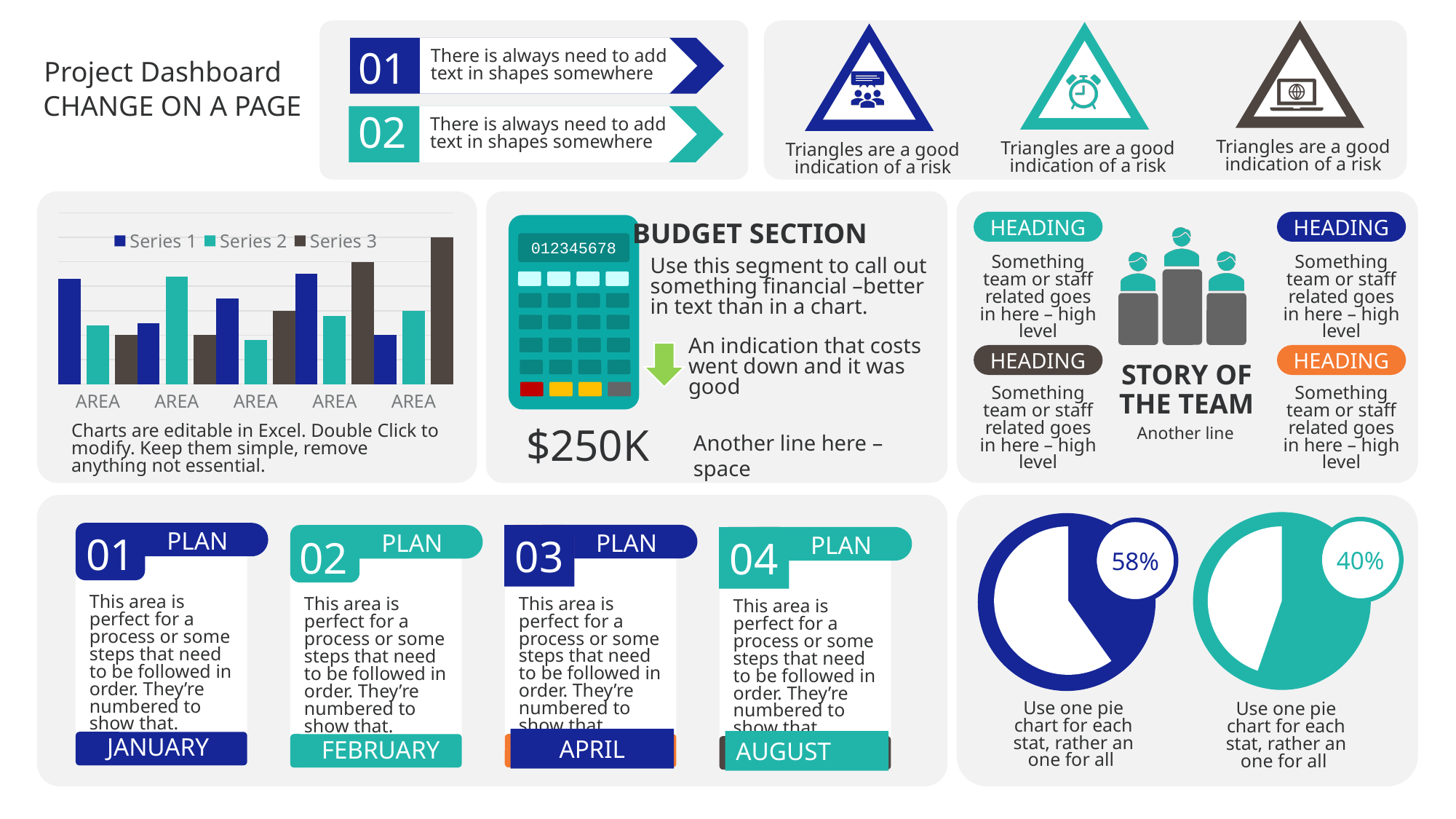
In the bar chart, which series has the tallest bar in the second category group? Series 2 What share is shown on the right (teal) pie chart in the bottom-right panel? 40% In the bar chart, which series has the single tallest bar? Series 3 In the bar chart, which series has the tallest bar in the first (leftmost) category group? Series 1 What colour are the Series 2 bars in the bar chart? Teal In the bar chart, which series has the shortest bar in the fifth (rightmost) category group? Series 1 What label is used for every category on the x axis of the bar chart? AREA What kind of chart is shown in the left panel with the Series 1, Series 2 and Series 3 legend? Bar chart How many category groups are plotted along the x axis of the bar chart? 5 What share is shown on the left (dark blue) pie chart in the bottom-right panel? 58% In the bar chart's first category group, which is larger: the Series 1 bar or the Series 3 bar? Series 1 How many series does the legend of the bar chart list? 3